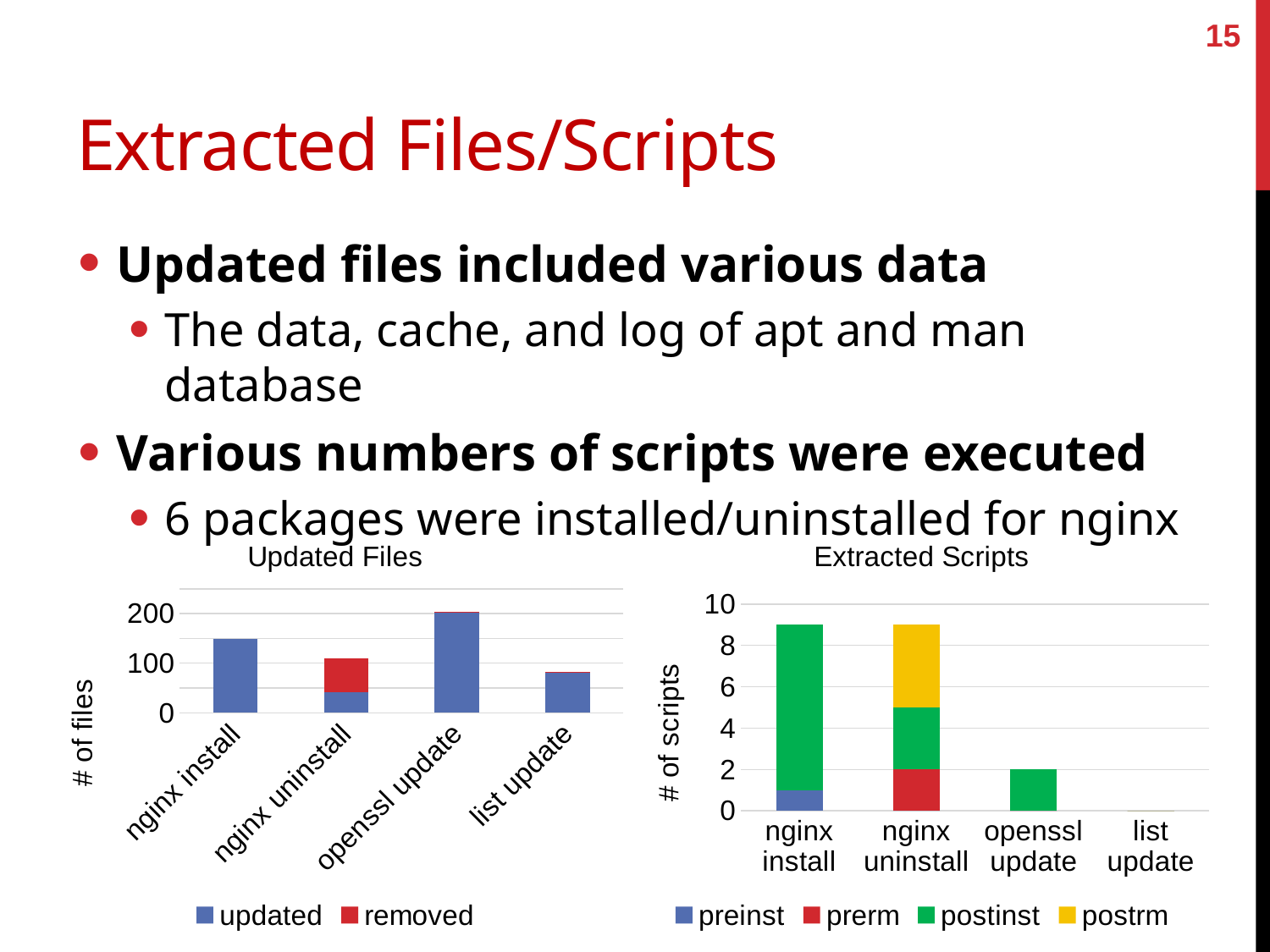
In the "Updated Files" chart, which category has the tallest bar? openssl update How many series does the legend of the "Updated Files" chart list? 2 In the "Updated Files" chart, which bar is taller: nginx install or nginx uninstall? nginx install How many categories are shown on the x axis of the "Extracted Scripts" chart? 4 In the "Extracted Scripts" chart, what is the prerm value for nginx uninstall? 2 In the "Updated Files" chart, is the updated value for nginx install greater or less than 100? greater How many series does the legend of the "Extracted Scripts" chart list? 4 In the "Extracted Scripts" chart, what is the postinst value for openssl update? 2 In the "Extracted Scripts" chart, which category has the lowest number of scripts? list update In the "Updated Files" chart, which category has the shortest bar? list update What kind of chart is the "Updated Files" chart? bar chart In the "Extracted Scripts" chart, is the total for nginx install greater or less than 8? greater